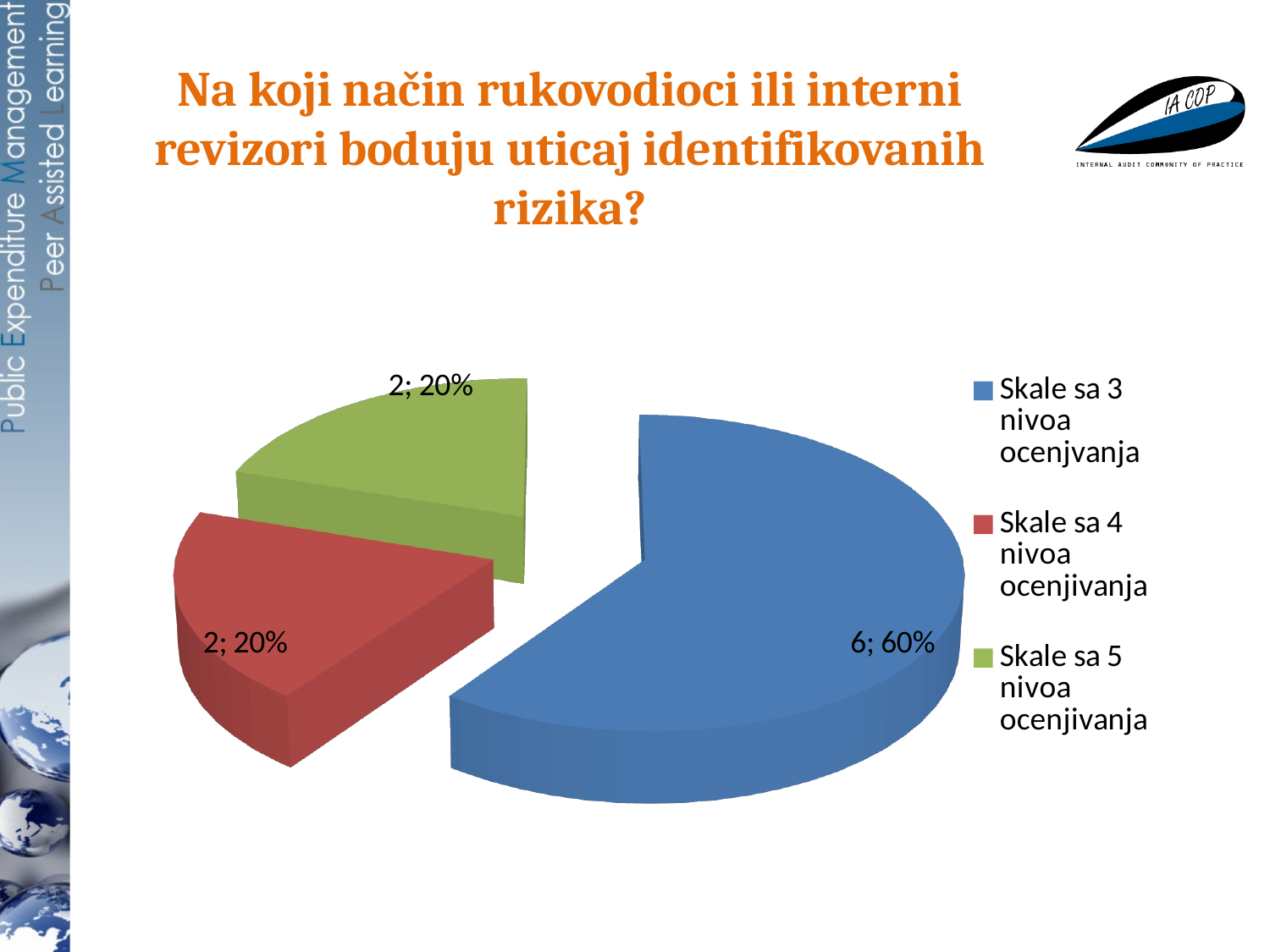
What percentage share does 'Skale sa 3 nivoa ocenjvanja' have? 60% What percentage share does 'Skale sa 5 nivoa ocenjivanja' have? 20% What is the count for 'Skale sa 4 nivoa ocenjivanja'? 2 How many slices does the pie chart have? 3 How many entries does the legend list? 3 What is the difference in count between 'Skale sa 3 nivoa ocenjvanja' and 'Skale sa 4 nivoa ocenjivanja'? 4 Which is larger: the share for 'Skale sa 3 nivoa ocenjvanja' or 'Skale sa 5 nivoa ocenjivanja'? Skale sa 3 nivoa ocenjvanja What is the total count across all slices? 10 What is the count for 'Skale sa 3 nivoa ocenjvanja'? 6 What kind of chart is shown on the slide? pie chart What colour is the slice for 'Skale sa 4 nivoa ocenjivanja'? red Which category has the largest slice? Skale sa 3 nivoa ocenjvanja